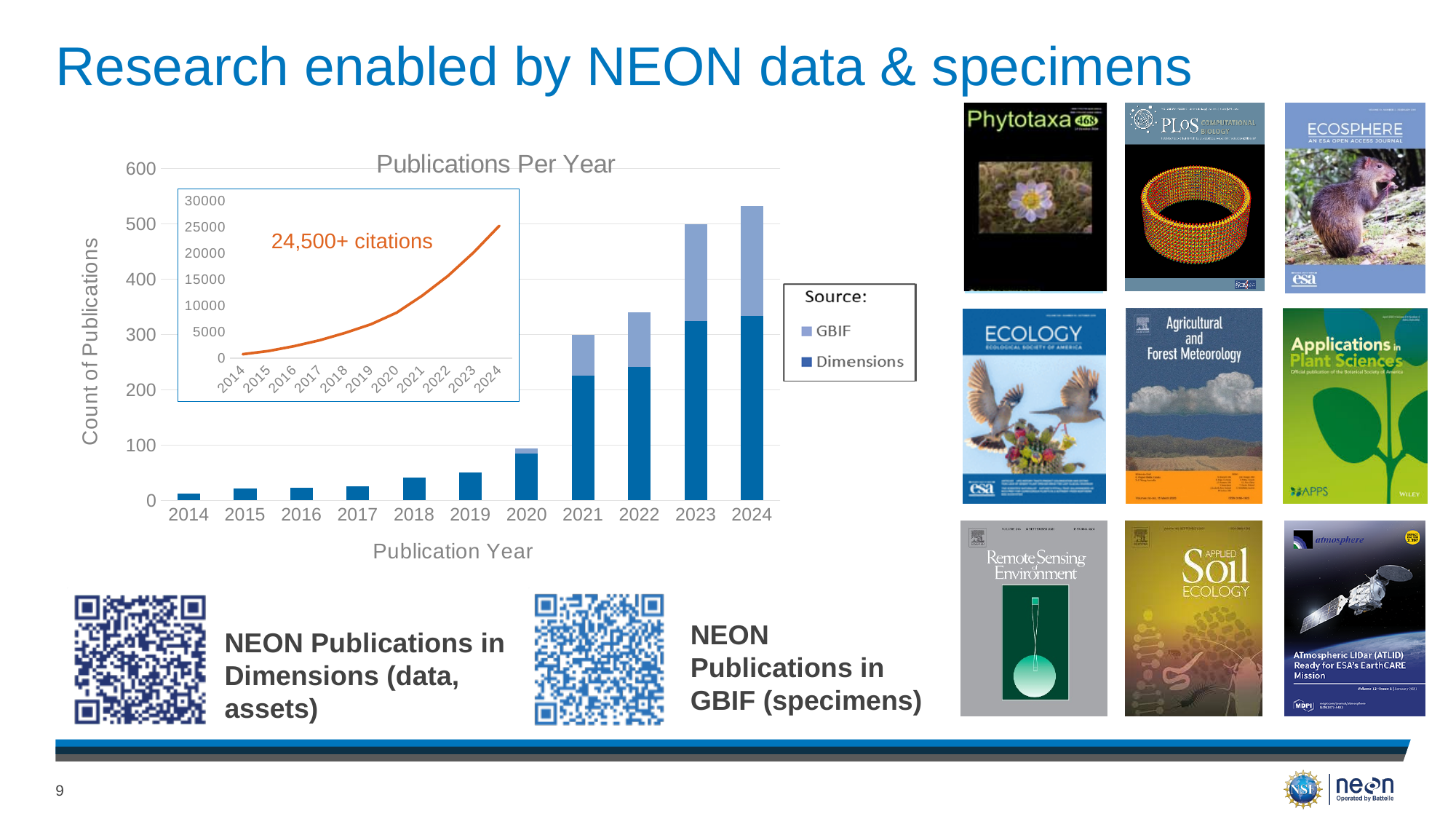
In the 'Publications Per Year' chart, which year has the lowest total count of publications? 2014 How many series does the legend of the 'Publications Per Year' chart list? 2 In the 'Publications Per Year' chart, is the total count of publications for 2024 greater or less than 500? greater In the 'Publications Per Year' chart, is the Dimensions value for 2024 greater or less than 300? greater In the 'Publications Per Year' chart, how many publication years are shown on the x axis? 11 In the 'Publications Per Year' chart, which year has the highest total count of publications? 2024 What citation figure is annotated on the inset line chart? 24,500+ citations In the 'Publications Per Year' chart, which year has the larger total count of publications, 2022 or 2023? 2023 In the inset line chart of citations, do the values rise or fall from 2014 to 2024? rise What kind of chart is the main 'Publications Per Year' chart? Stacked bar chart In the inset line chart of citations, is the value for 2022 greater or less than 10000? greater